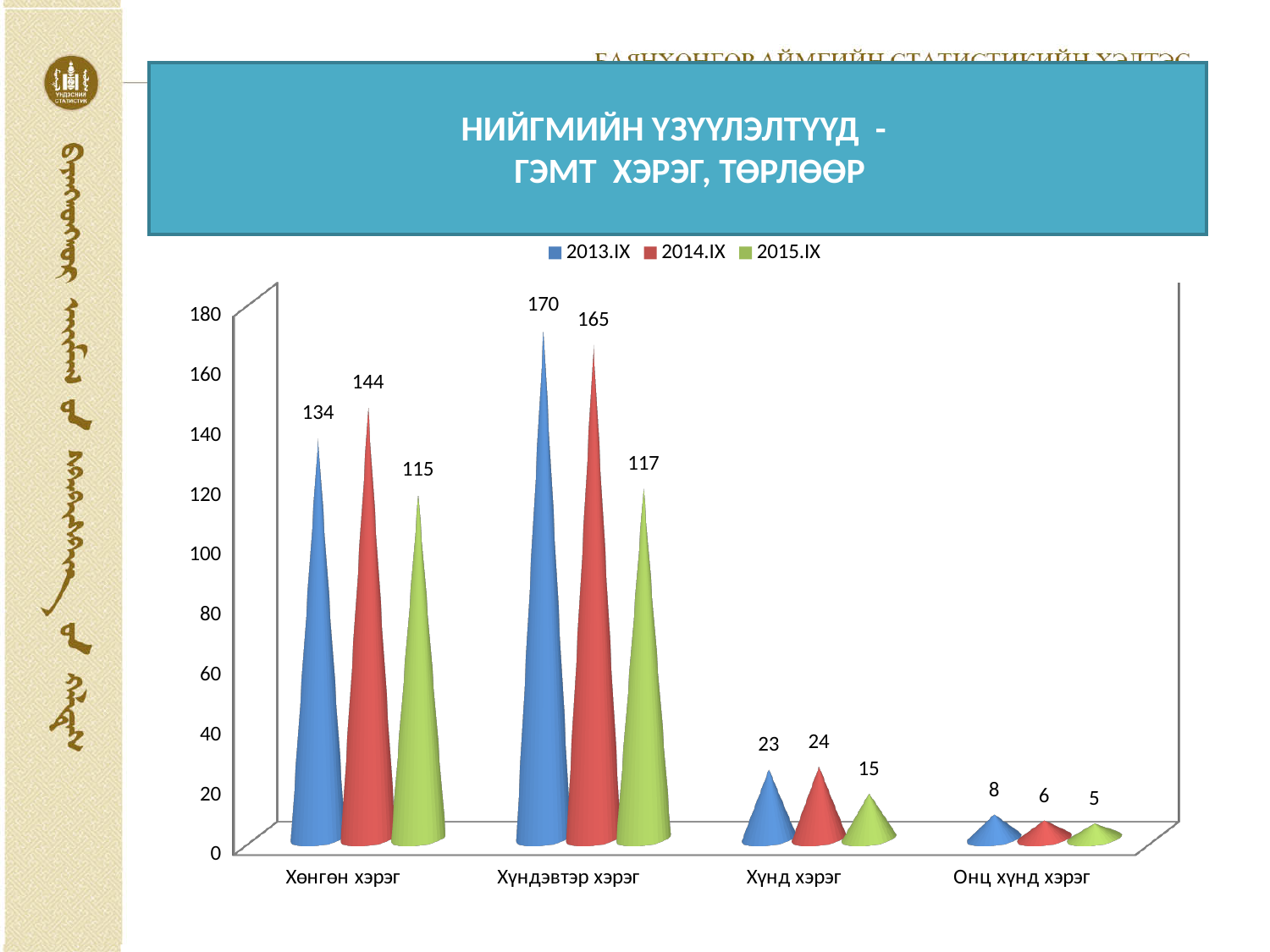
How many series does the legend list? 3 Do the values for the 2015.IX series rise or fall from Хүндэвтэр хэрэг to Онц хүнд хэрэг? fall What is the value for Хүндэвтэр хэрэг in the 2013.IX series? 170 Which is larger for Хүнд хэрэг: the 2013.IX value or the 2014.IX value? 2014.IX What is the value for Хөнгөн хэрэг in the 2015.IX series? 115 Which category has the highest value in the 2014.IX series? Хүндэвтэр хэрэг How many categories are shown on the x axis? 4 What kind of chart is shown on the slide? bar chart Which category has the lowest value in the 2015.IX series? Онц хүнд хэрэг Which colour represents the 2014.IX series in the legend? red What is the value for Онц хүнд хэрэг in the 2014.IX series? 6 What is the difference between the 2013.IX and 2015.IX values for Хүндэвтэр хэрэг? 53